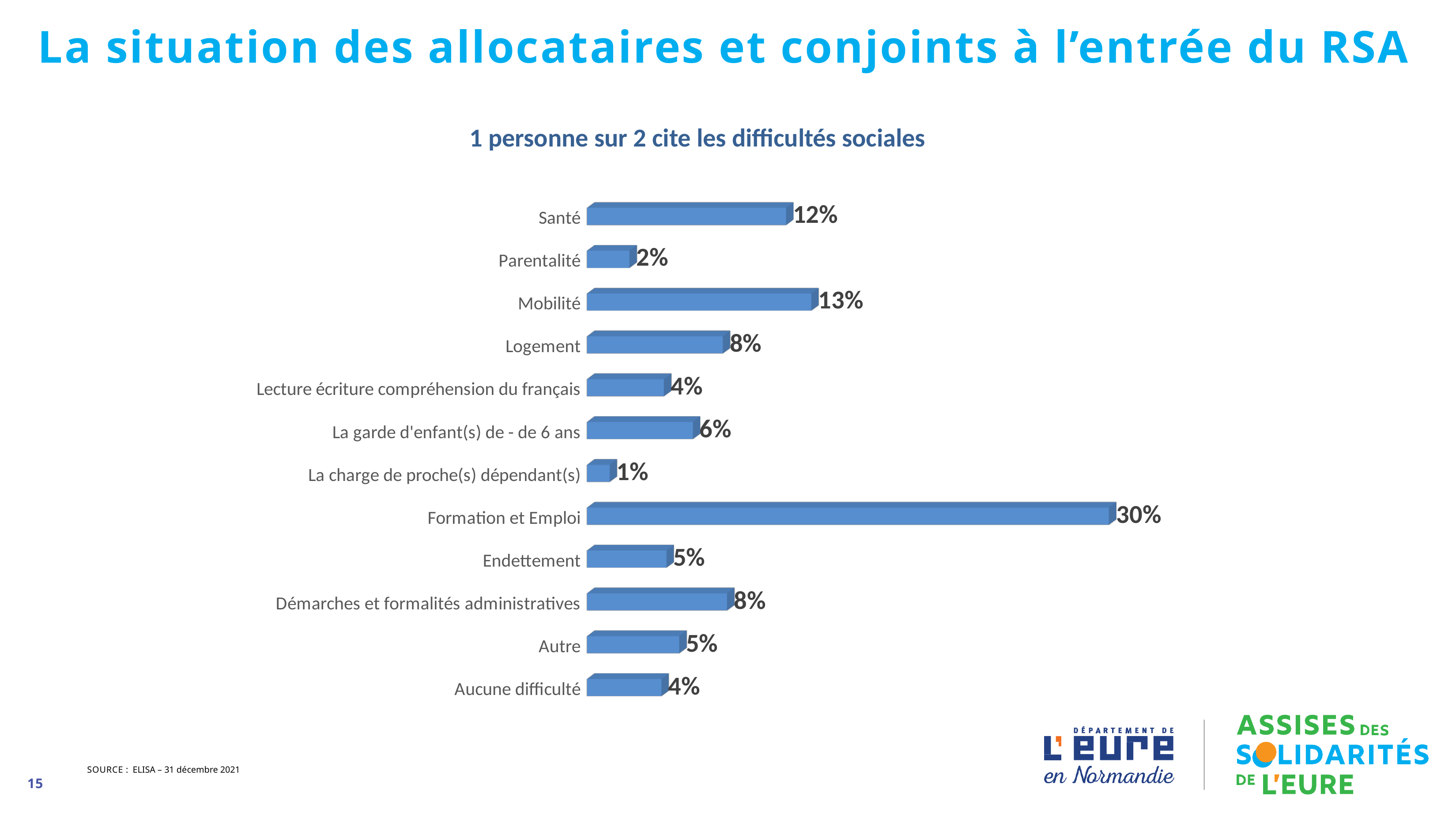
What kind of chart is shown on the slide? Bar chart Which is larger, the value for Mobilité or the value for Santé? Mobilité What is the difference between the values for Formation et Emploi and Santé? 18% What is the value for Mobilité? 13% What is the difference between the values for Logement and Parentalité? 6% Which category has the highest value? Formation et Emploi What is the value for La garde d'enfant(s) de - de 6 ans? 6% How many categories are shown in the chart? 12 Which category has the lowest value? La charge de proche(s) dépendant(s) What is the value for Aucune difficulté? 4% What is the value for Formation et Emploi? 30% What is the title shown above the chart? 1 personne sur 2 cite les difficultés sociales